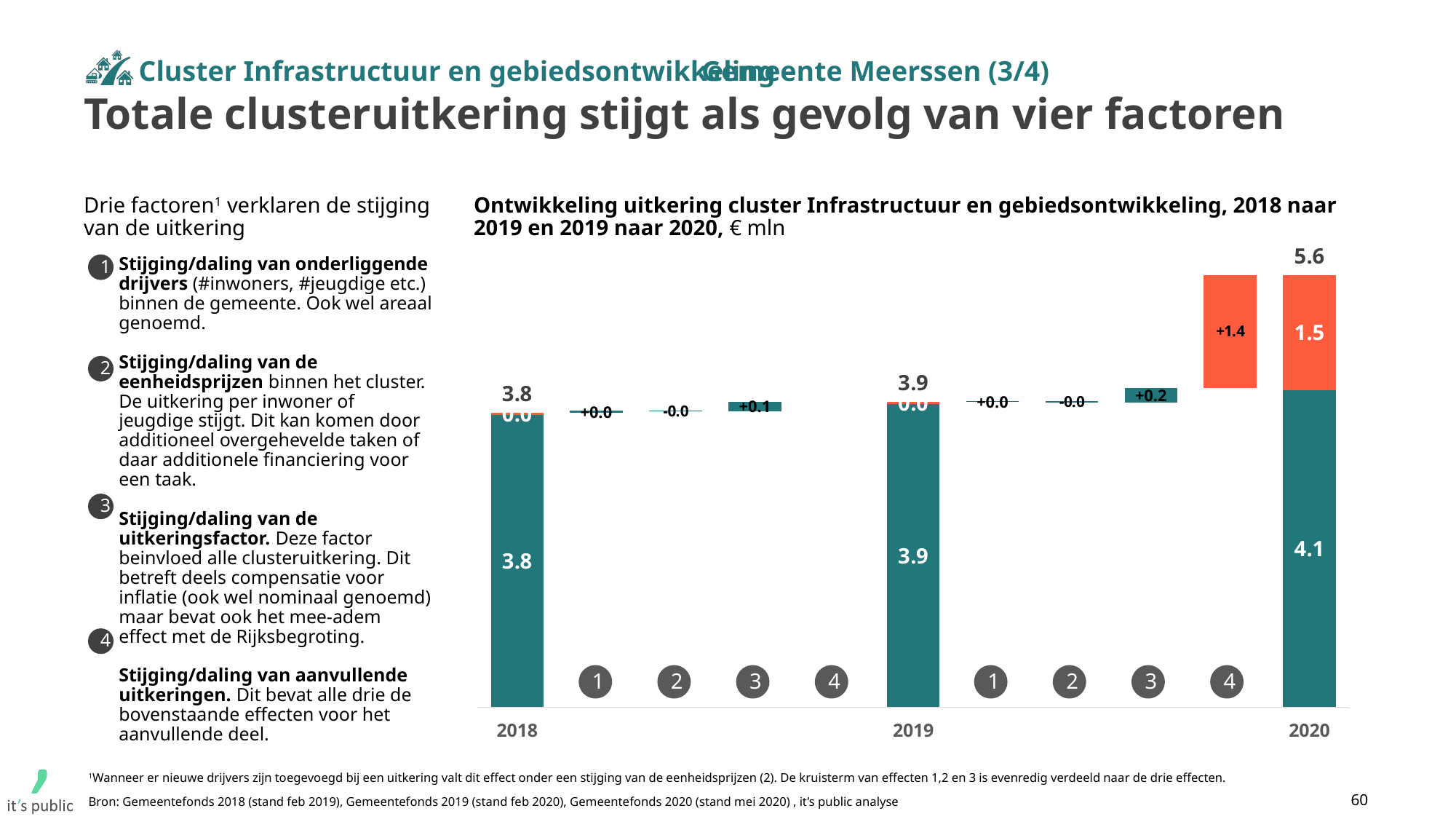
What is the value of factor 3 between 2018 and 2019? +0.1 What is the total value shown above the 2020 bar? 5.6 Do the yearly totals rise or fall from 2018 to 2020? rise What is the value of factor 4 between 2019 and 2020? +1.4 What is the difference between the 2020 total and the 2018 total? 1.8 What is the value of factor 3 between 2019 and 2020? +0.2 What is the total value shown above the 2018 bar? 3.8 What is the value of the orange (top) segment of the 2020 bar? 1.5 What unit is stated in the chart title? € mln Which year has the highest total value? 2020 What is the value of the teal (bottom) segment of the 2020 bar? 4.1 What is the total value shown above the 2019 bar? 3.9